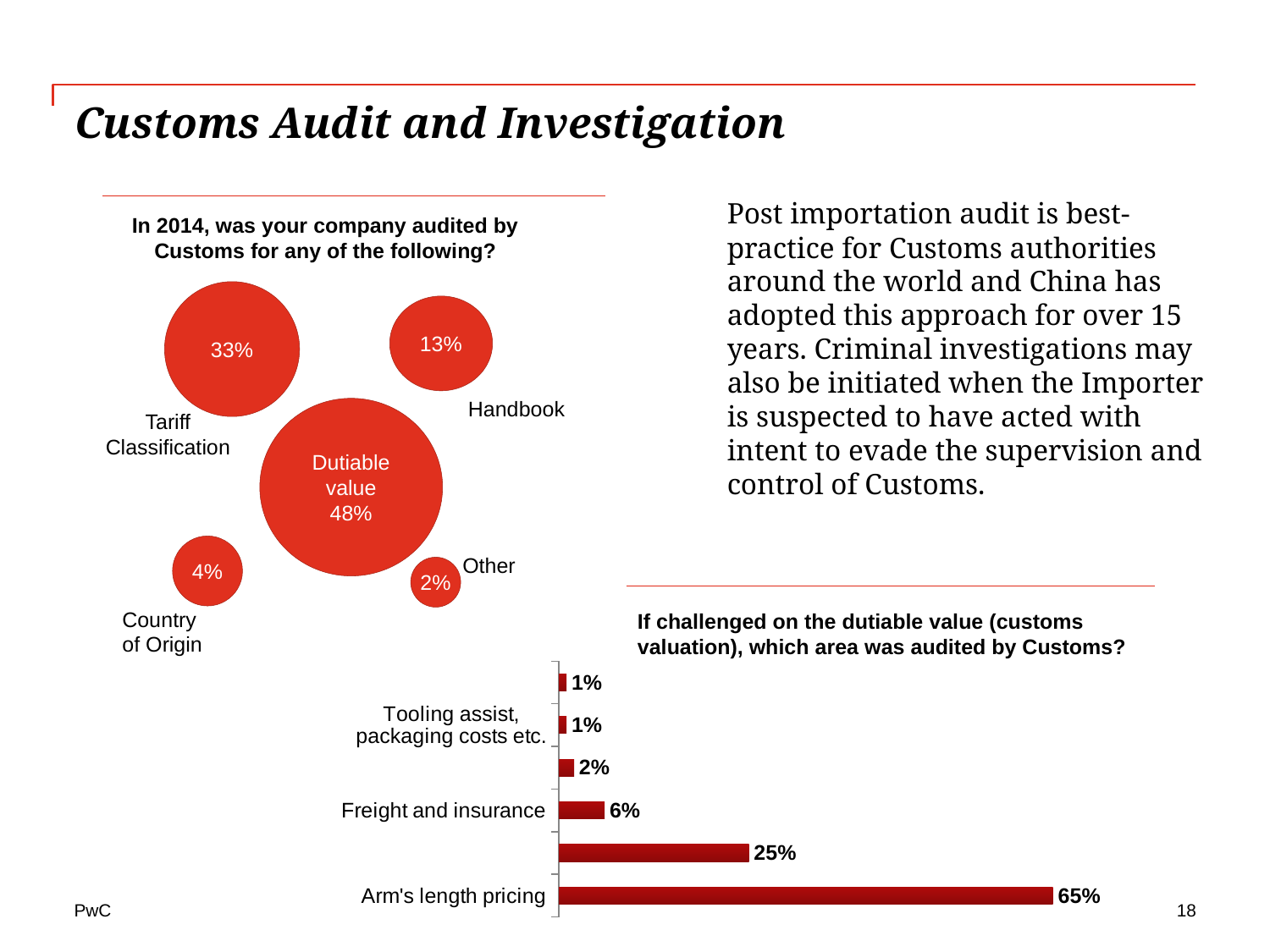
In the bubble chart 'In 2014, was your company audited by Customs for any of the following?', which category has the lowest value? Other In the bubble chart 'In 2014, was your company audited by Customs for any of the following?', what is the difference between Dutiable value and Tariff Classification? 15 percentage points In the bubble chart 'In 2014, was your company audited by Customs for any of the following?', how many categories are shown? 5 In the bar chart 'If challenged on the dutiable value (customs valuation), which area was audited by Customs?', what is the value for Tooling assist, packaging costs etc.? 1% In the bubble chart 'In 2014, was your company audited by Customs for any of the following?', what is the value for Dutiable value? 48% In the bubble chart 'In 2014, was your company audited by Customs for any of the following?', what is the value for Handbook? 13% In the bar chart 'If challenged on the dutiable value (customs valuation), which area was audited by Customs?', which is larger, Freight and insurance or Tooling assist, packaging costs etc.? Freight and insurance In the bubble chart 'In 2014, was your company audited by Customs for any of the following?', what is the value for Tariff Classification? 33% What kind of chart is the chart at the bottom of the slide, 'If challenged on the dutiable value (customs valuation), which area was audited by Customs?'? Bar chart In the bar chart 'If challenged on the dutiable value (customs valuation), which area was audited by Customs?', what is the value for Arm's length pricing? 65% In the bubble chart 'In 2014, was your company audited by Customs for any of the following?', which category has the highest value? Dutiable value In the bar chart 'If challenged on the dutiable value (customs valuation), which area was audited by Customs?', what is the value for Freight and insurance? 6%